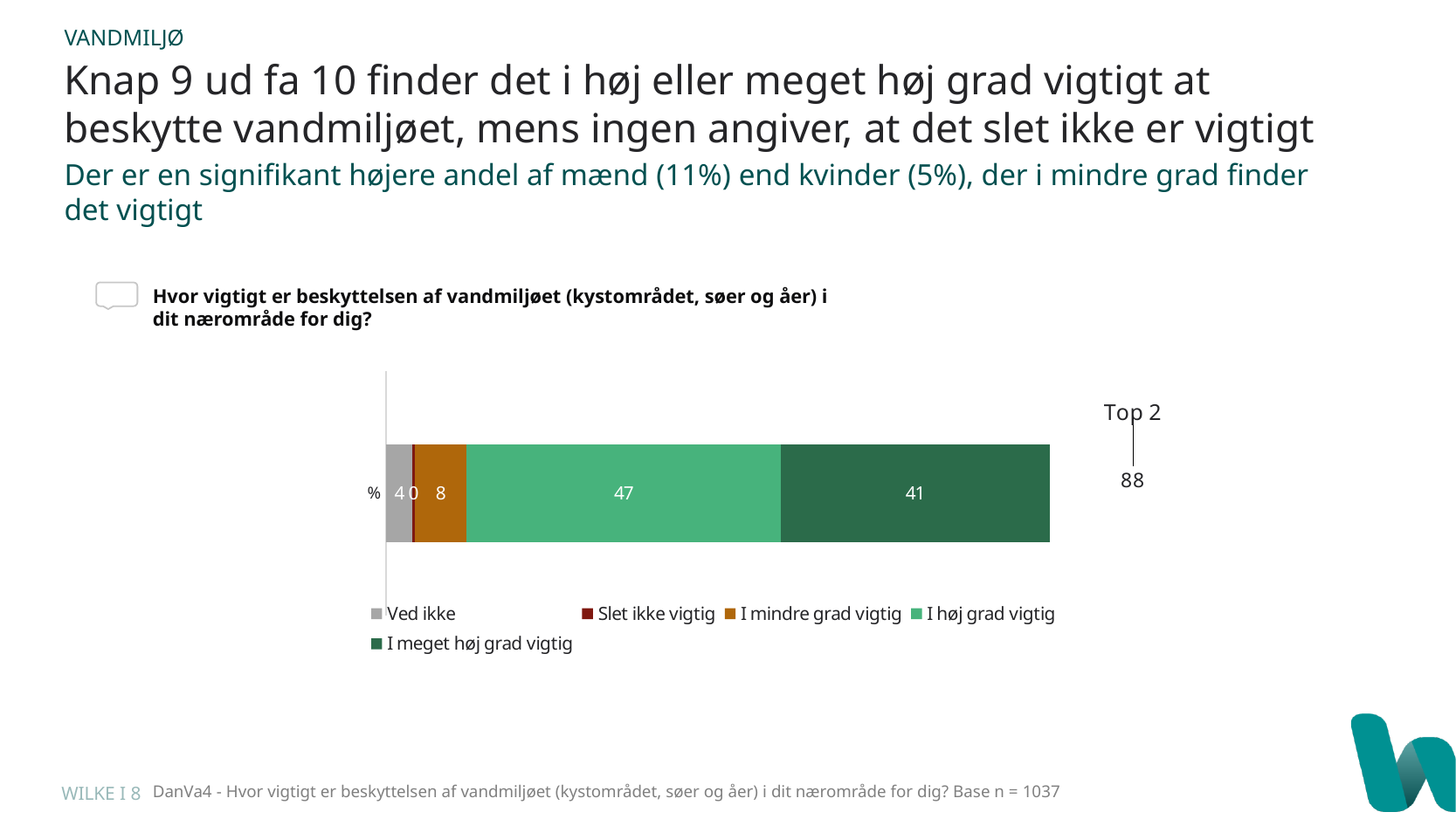
What is the value for "Ved ikke"? 4 Which is larger, the value for "I mindre grad vigtig" or the value for "Ved ikke"? I mindre grad vigtig Which series has the lowest value in the bar? Slet ikke vigtig What is the value for "I høj grad vigtig"? 47 What kind of chart is shown on the slide? Stacked bar chart What is the difference between the values for "I høj grad vigtig" and "I meget høj grad vigtig"? 6 What "Top 2" value is shown next to the bar? 88 What is the value for "I meget høj grad vigtig"? 41 What is the value for "Slet ikke vigtig"? 0 What is the value for "I mindre grad vigtig"? 8 How many series does the legend list? 5 Which series has the highest value in the bar? I høj grad vigtig